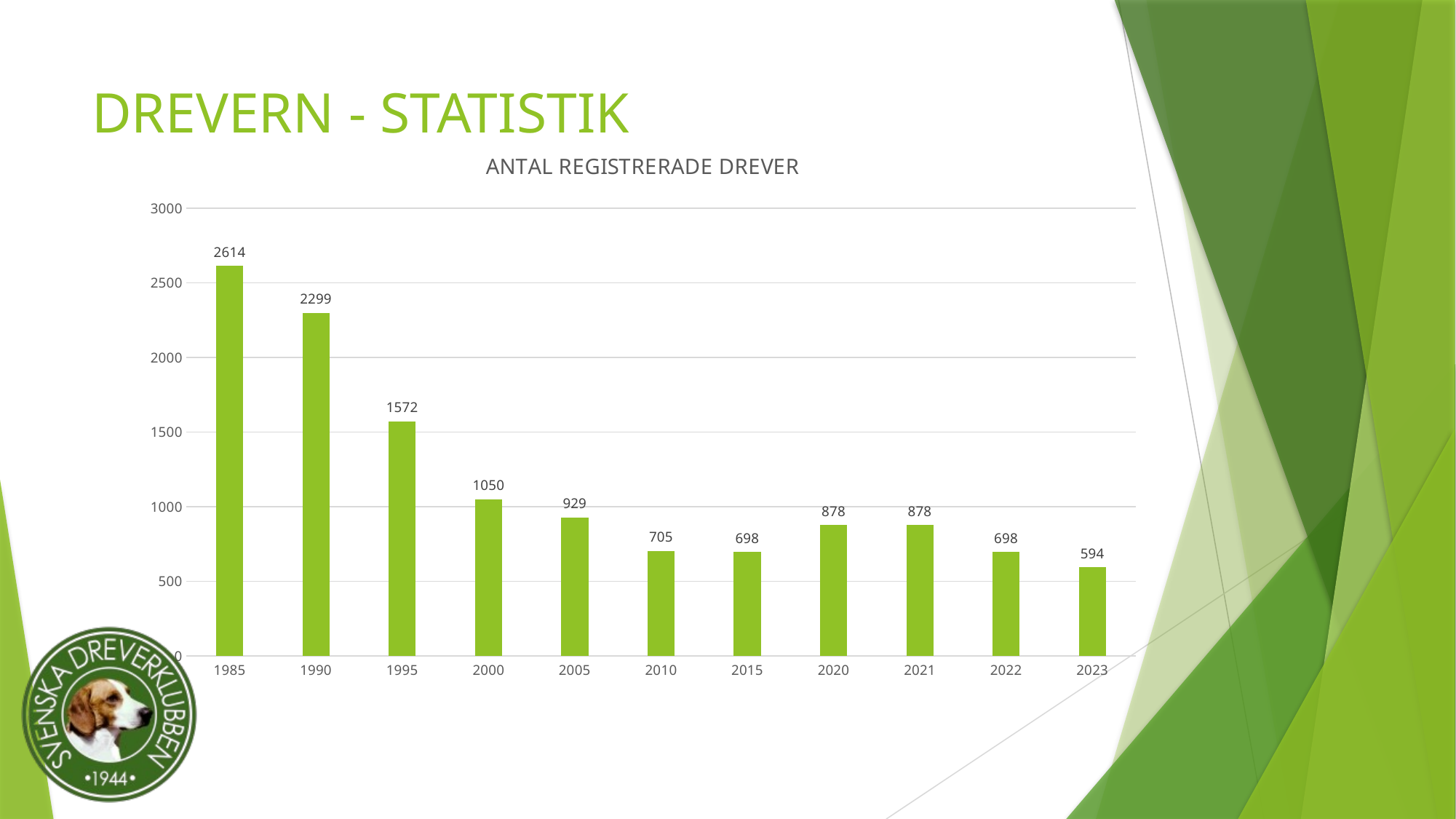
What is the difference between the values for 2022 and 2023? 104 Is the value for 1995 greater or less than 1500? greater How many years are shown on the x axis? 11 Which year has the highest number of registered Drever? 1985 What is the value shown for 2000? 1050 What kind of chart is shown on the slide? Bar chart What is the title of the chart? ANTAL REGISTRERADE DREVER Which is larger, the value for 2005 or the value for 2010? 2005 What is the value shown for 2023? 594 What is the number of registered Drever in 1985? 2614 Which year has the lowest number of registered Drever? 2023 What is the difference between the values for 1985 and 1990? 315